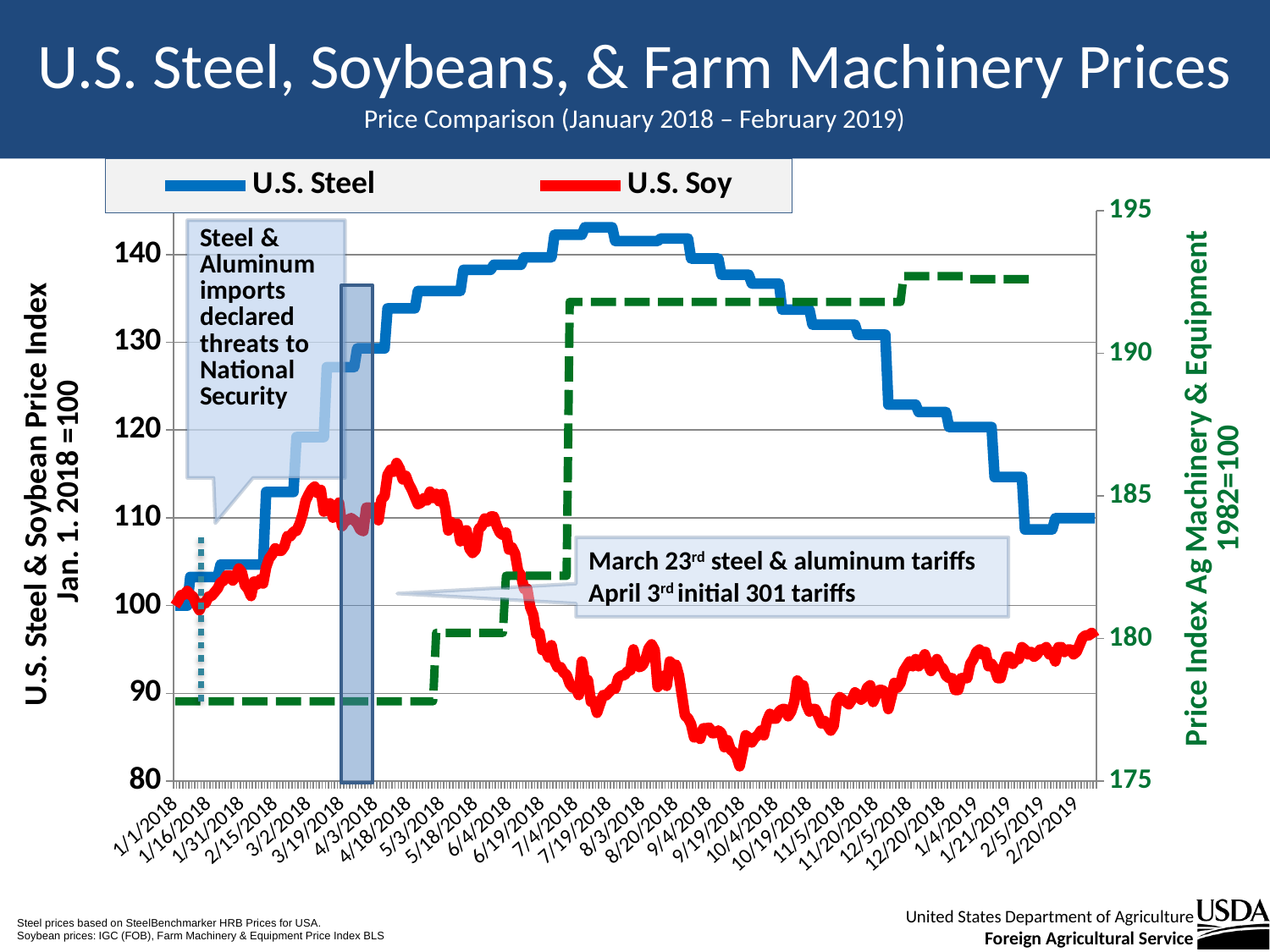
Does the U.S. Soy line rise or fall from 6/4/2018 to 9/19/2018? fall What is the title of the chart on the slide? U.S. Steel, Soybeans, & Farm Machinery Prices Which two series are named in the chart legend? U.S. Steel and U.S. Soy Which series is higher around 7/4/2018, U.S. Steel or U.S. Soy? U.S. Steel How many series does the chart legend list? 2 What kind of chart is shown on the slide? line chart Is the U.S. Soy value around 9/19/2018 greater or less than 90? less Does the U.S. Steel line rise or fall from 7/19/2018 to 2/20/2019? fall Is the U.S. Steel value around 7/19/2018 greater or less than 140? greater Is the green dashed Ag Machinery & Equipment price index at 1/1/2018 greater or less than 180 on the right axis? less